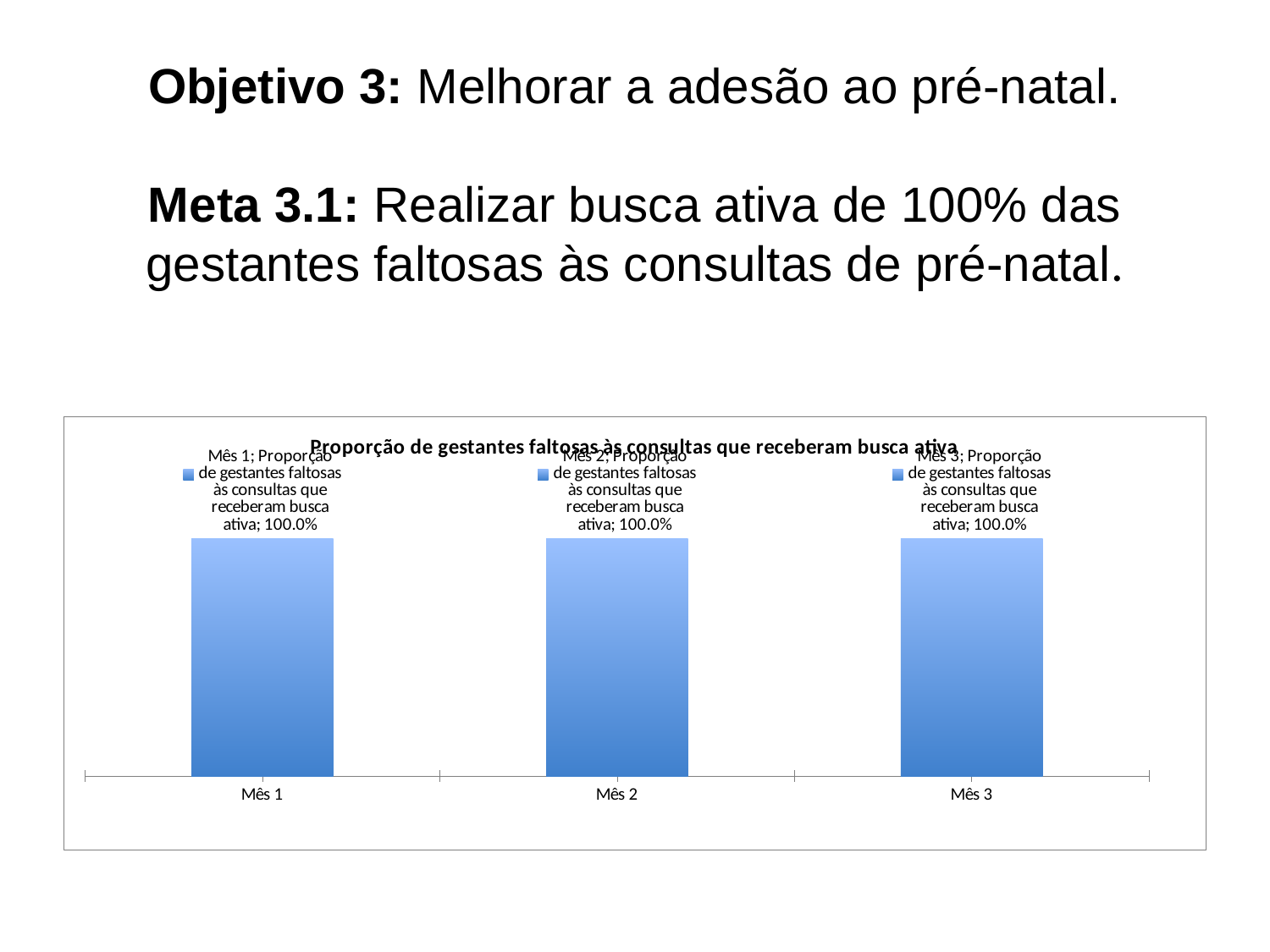
Do the values rise, fall, or stay the same from Mês 1 to Mês 3? Stay the same What is the difference between the values for Mês 1 and Mês 3? 0.0% What kind of chart is shown on the slide? Bar chart What is the title of the chart? Proporção de gestantes faltosas às consultas que receberam busca ativa What is the value for Mês 1 in the chart? 100.0% How many categories (months) are plotted in the chart? 3 Is the value for Mês 2 larger than, smaller than, or equal to the value for Mês 3? Equal What is the value for Mês 3 in the chart? 100.0% What is the label of the first category on the x axis? Mês 1 What is the value for Mês 2 in the chart? 100.0%